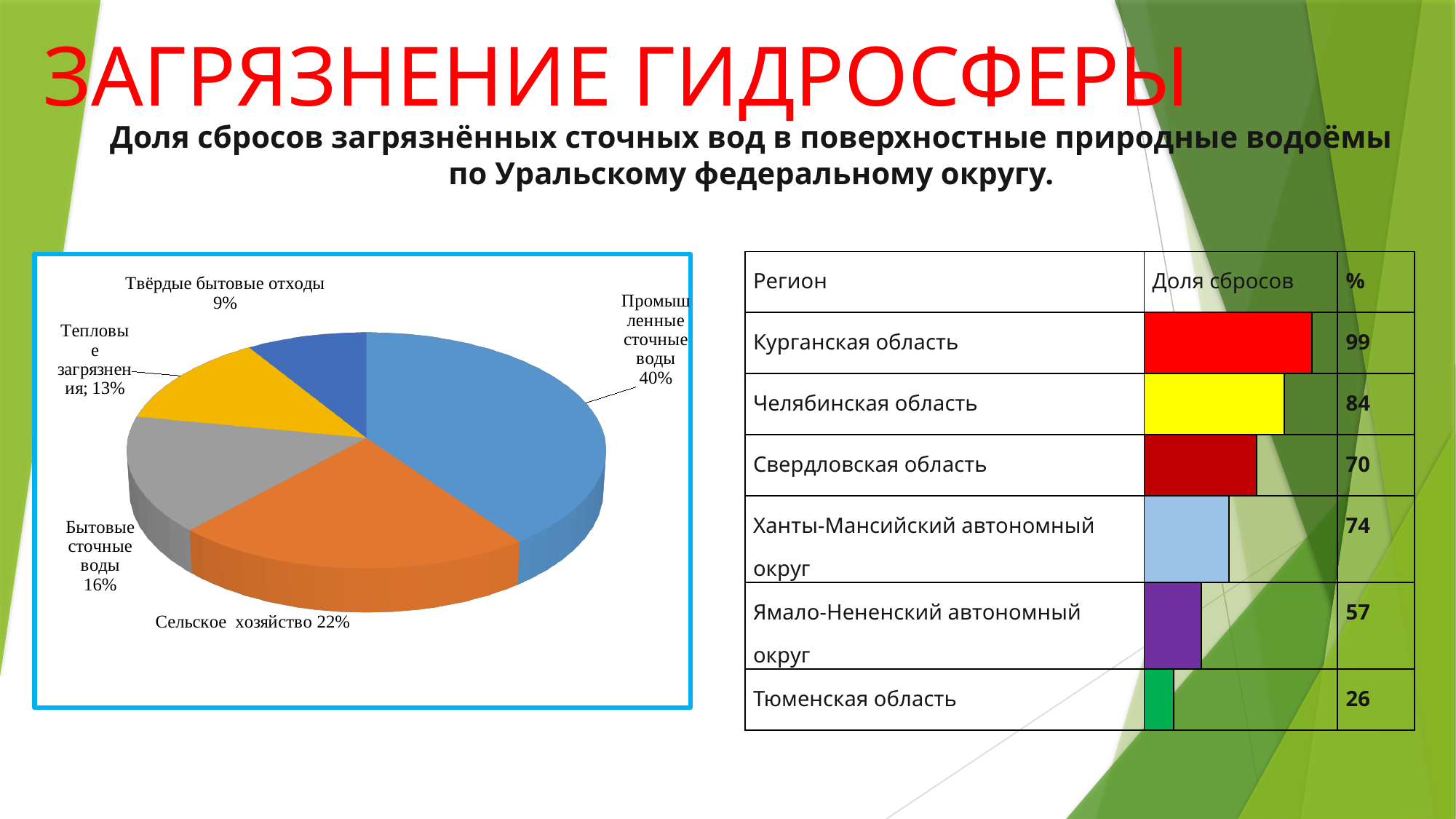
On the pie chart on the left, what share is labelled for Тепловые загрязнения? 13% In the table with bars on the right, what is the % value for Курганская область? 99 On the pie chart on the left, what share is labelled for Промышленные сточные воды? 40% In the table with bars on the right, which region has the lowest % value? Тюменская область On the pie chart on the left, which is larger: Бытовые сточные воды or Тепловые загрязнения? Бытовые сточные воды On the pie chart on the left, which category has the largest slice? Промышленные сточные воды How many slices does the pie chart on the left have? 5 In the table with bars on the right, what is the difference between the % values for Челябинская область and Свердловская область? 14 What kind of chart is shown on the left of the slide? Pie chart On the pie chart on the left, what share is labelled for Сельское хозяйство? 22% On the pie chart on the left, what is the difference in percentage points between Промышленные сточные воды and Бытовые сточные воды? 24 On the pie chart on the left, which category has the smallest slice? Твёрдые бытовые отходы